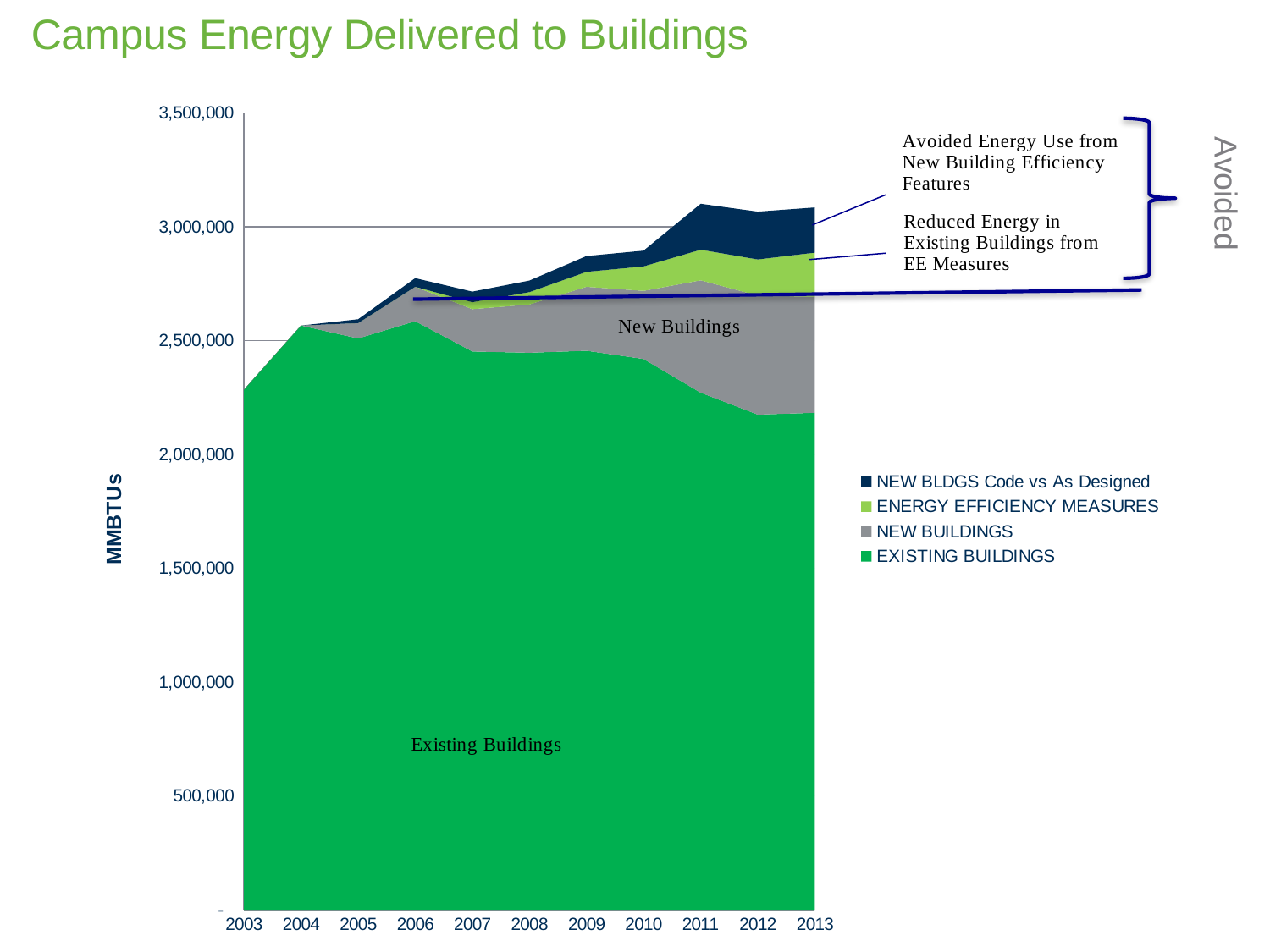
What is the label on the vertical axis? MMBTUs Is the total stacked value in 2013 greater or less than 3,000,000? greater What is the first year shown on the x axis? 2003 Is the total stacked value in 2003 greater or less than 2,500,000? less Is the value for EXISTING BUILDINGS in 2006 greater or less than 2,500,000? greater What kind of chart is shown on the slide? Stacked area chart Does the EXISTING BUILDINGS area rise or fall from 2006 to 2013? fall How many years are shown along the x axis? 11 Which year has the larger value for EXISTING BUILDINGS, 2004 or 2013? 2004 How many series does the legend list? 4